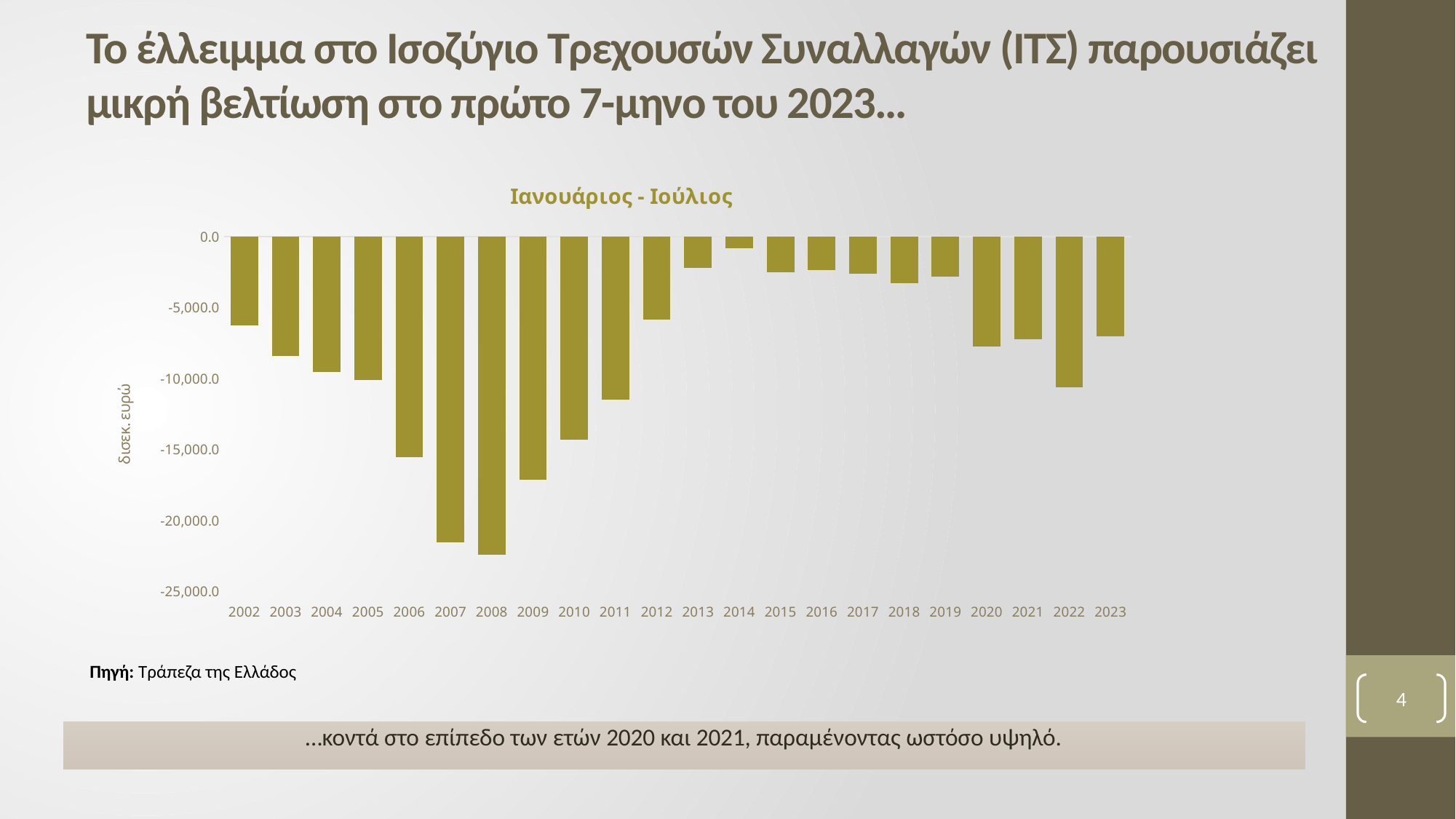
How many years are shown on the x axis of the chart? 22 Which year has the lowest (most negative) value in the chart? 2008 Is the value for 2013 greater or less than -5,000.0? greater Is the value for 2020 greater or less than -10,000.0? greater Which year has the lower (more negative) value, 2022 or 2023? 2022 What is the title of the chart? Ιανουάριος - Ιούλιος Is the value for 2022 greater or less than -10,000.0? less What kind of chart is shown on the slide? bar chart Do the values rise or fall from 2008 to 2014? rise Which year has the highest value (closest to zero) in the chart? 2014 Which year has the lower (more negative) value, 2007 or 2009? 2007